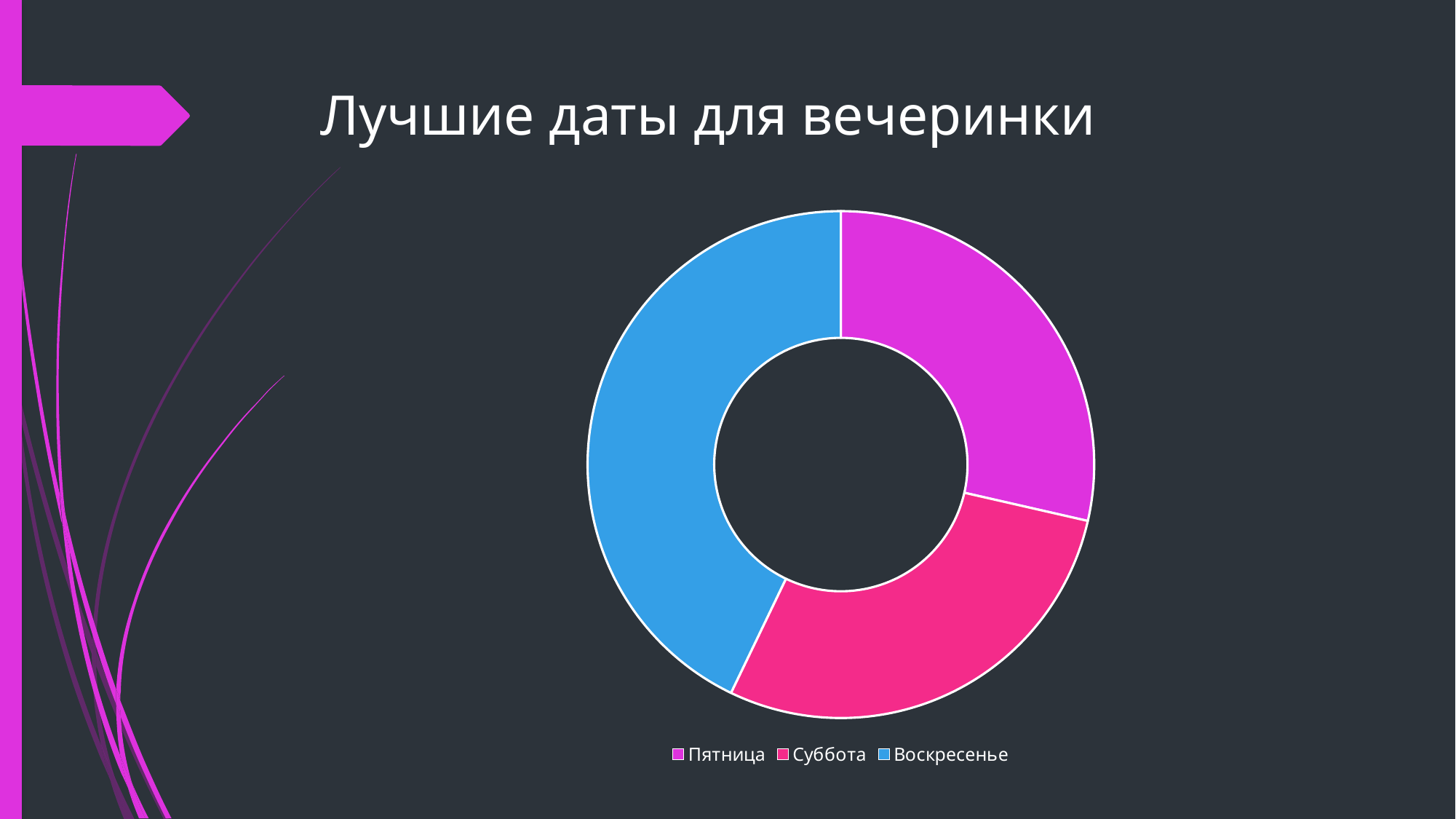
Which category has the largest slice in the chart? Воскресенье How many categories (slices) does the chart have? 3 Which slice is larger, Воскресенье or Пятница? Воскресенье How many entries does the chart legend list? 3 Which colour represents Воскресенье in the chart? Blue What is the title of the slide containing the chart? Лучшие даты для вечеринки What kind of chart is shown on the slide? Doughnut (pie) chart Which slice is larger, Воскресенье or Суббота? Воскресенье